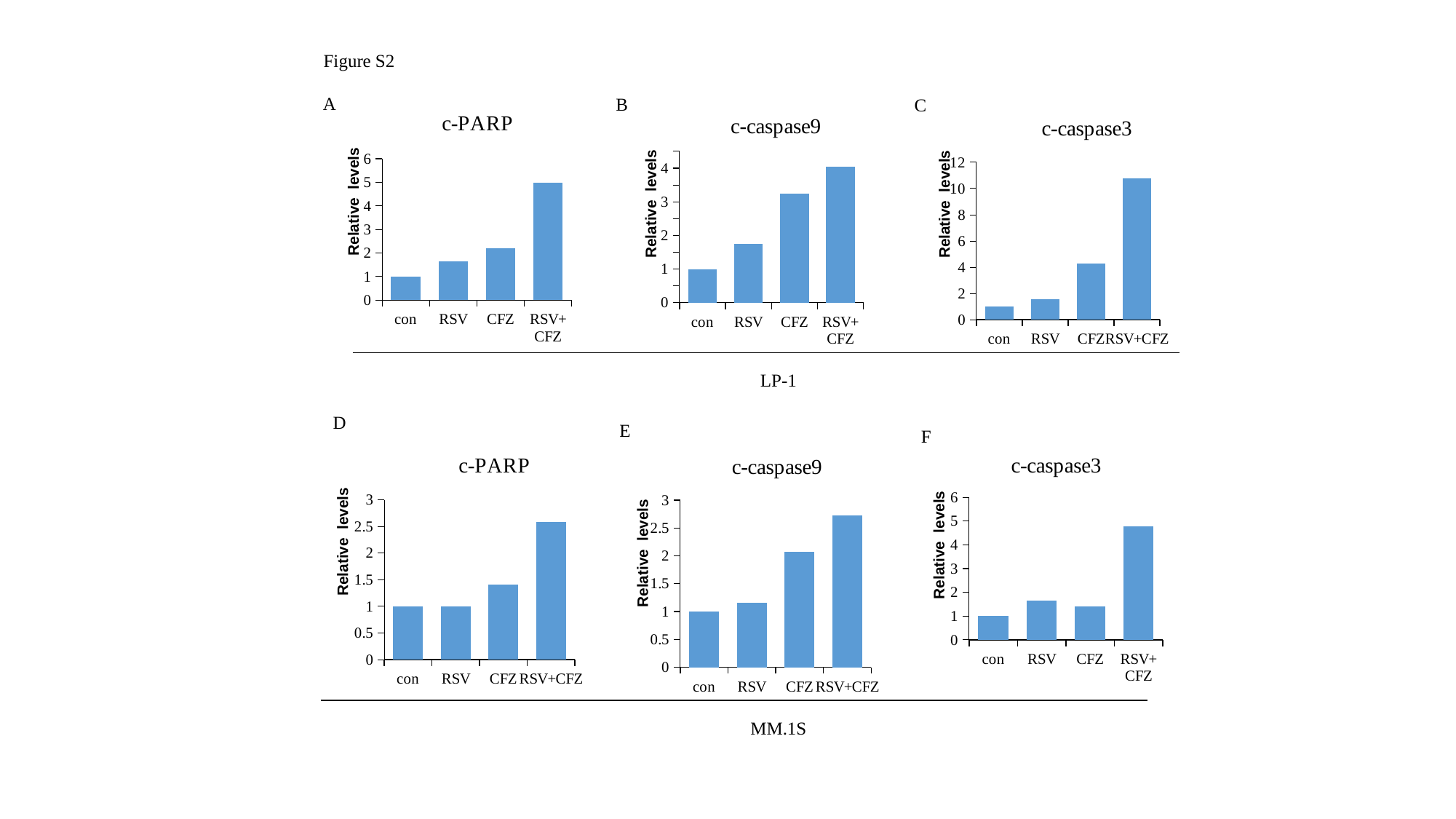
In chart B (c-caspase9, LP-1), is the value for CFZ greater or less than 2? greater In chart A (c-PARP, LP-1), what is the value for con? 1 In chart A (c-PARP, LP-1), is the value for RSV+CFZ greater or less than 4? greater In chart C (c-caspase3, LP-1), is the value for RSV+CFZ greater or less than 10? greater In chart B (c-caspase9, LP-1), do the values rise or fall from con to RSV+CFZ? rise How many categories are shown on the x axis of chart F (c-caspase3, MM.1S)? 4 In chart E (c-caspase9, MM.1S), which is larger, the value for CFZ or the value for RSV? CFZ What kind of chart is chart D (c-PARP, MM.1S)? bar chart In chart A (c-PARP, LP-1), which category has the highest value? RSV+CFZ In chart C (c-caspase3, LP-1), which category has the lowest value? con